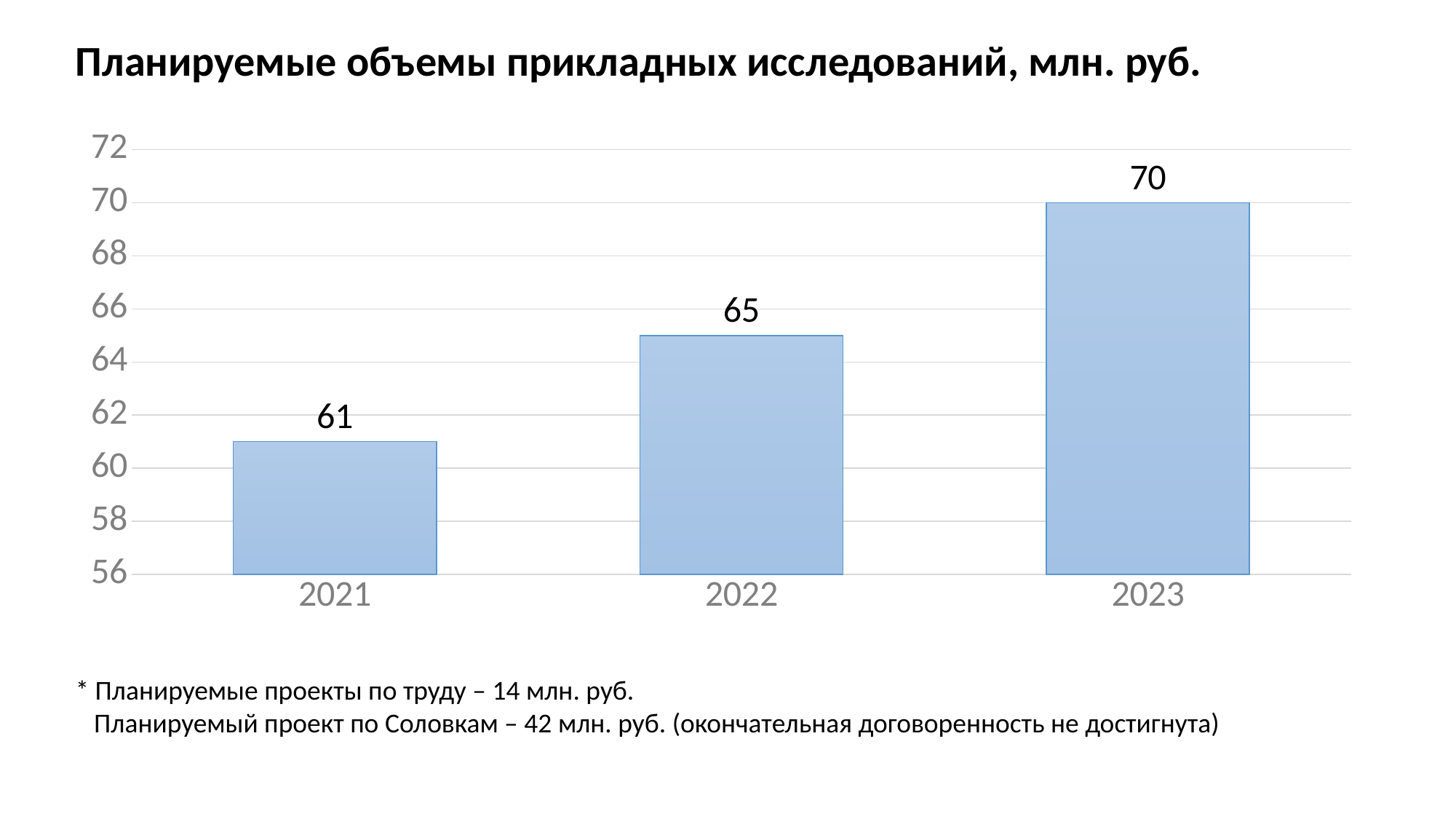
What is the difference between the planned volumes for 2022 and 2021? 4 What is the planned volume of applied research for 2021? 61 How many years are shown on the chart? 3 Which year has the lowest planned volume of applied research? 2021 Which year has the highest planned volume of applied research? 2023 What is the planned volume of applied research for 2023? 70 What kind of chart is shown on the slide? Bar chart What is the difference between the planned volumes for 2023 and 2021? 9 Which year has a larger planned volume, 2022 or 2023? 2023 What is the planned volume of applied research for 2022? 65 Do the planned volumes rise or fall from 2021 to 2023? Rise Is the value for 2022 greater or less than 64? greater